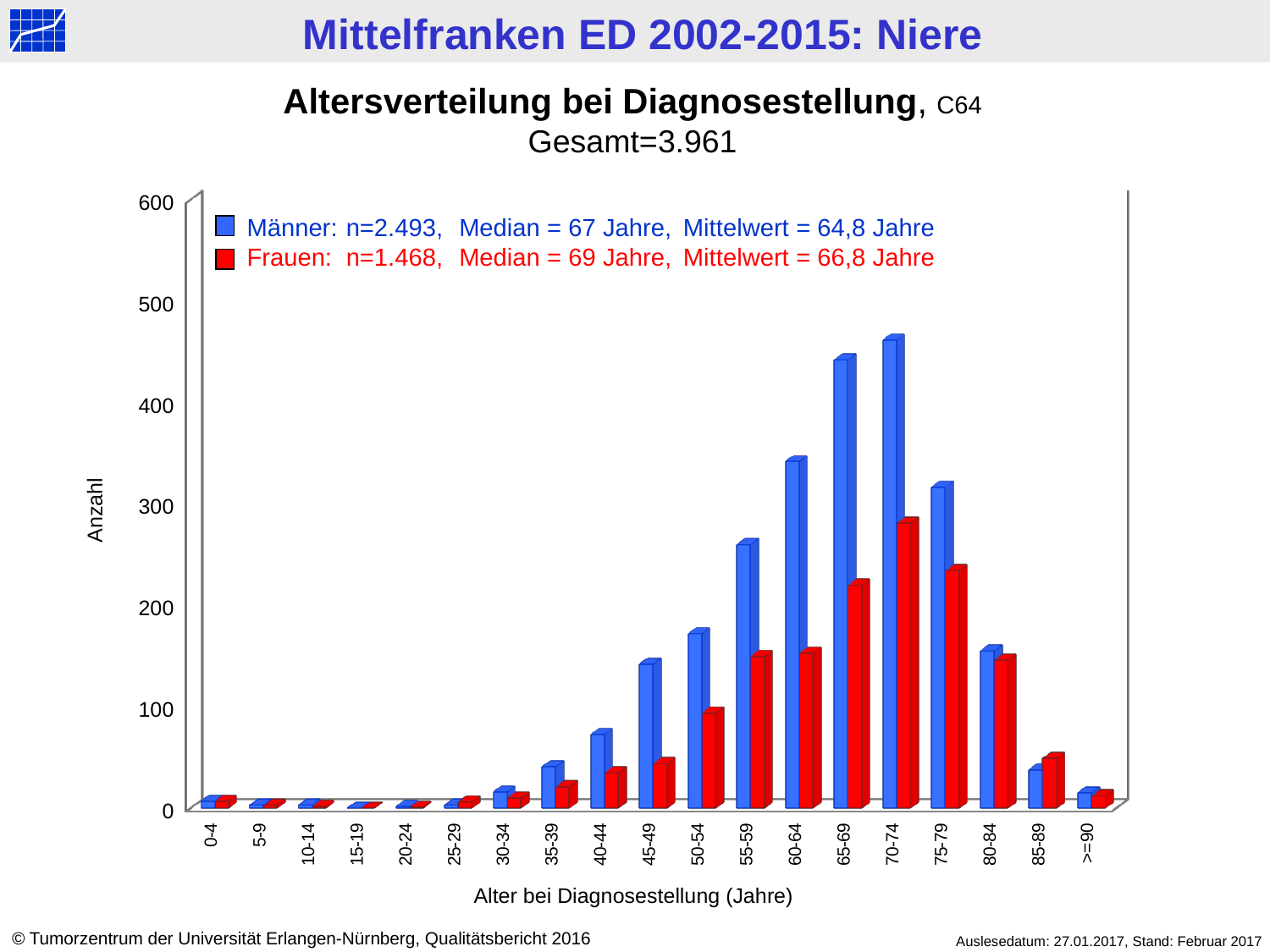
Is the value for Männer in the 65-69 age group greater or less than 400? greater How many series does the legend list? 2 Which age group has the highest value for Männer? 70-74 How many age groups are shown on the x axis? 19 Is the value for Männer in the 50-54 age group greater or less than 100? greater Is the value for Männer in the 60-64 age group greater or less than 300? greater What kind of chart is shown on the slide? bar chart In the 85-89 age group, which series has the larger value, Männer or Frauen? Frauen In the 65-69 age group, which series has the larger value, Männer or Frauen? Männer Which age group has the highest value for Frauen? 70-74 According to the legend, what is the n for Männer? n=2.493